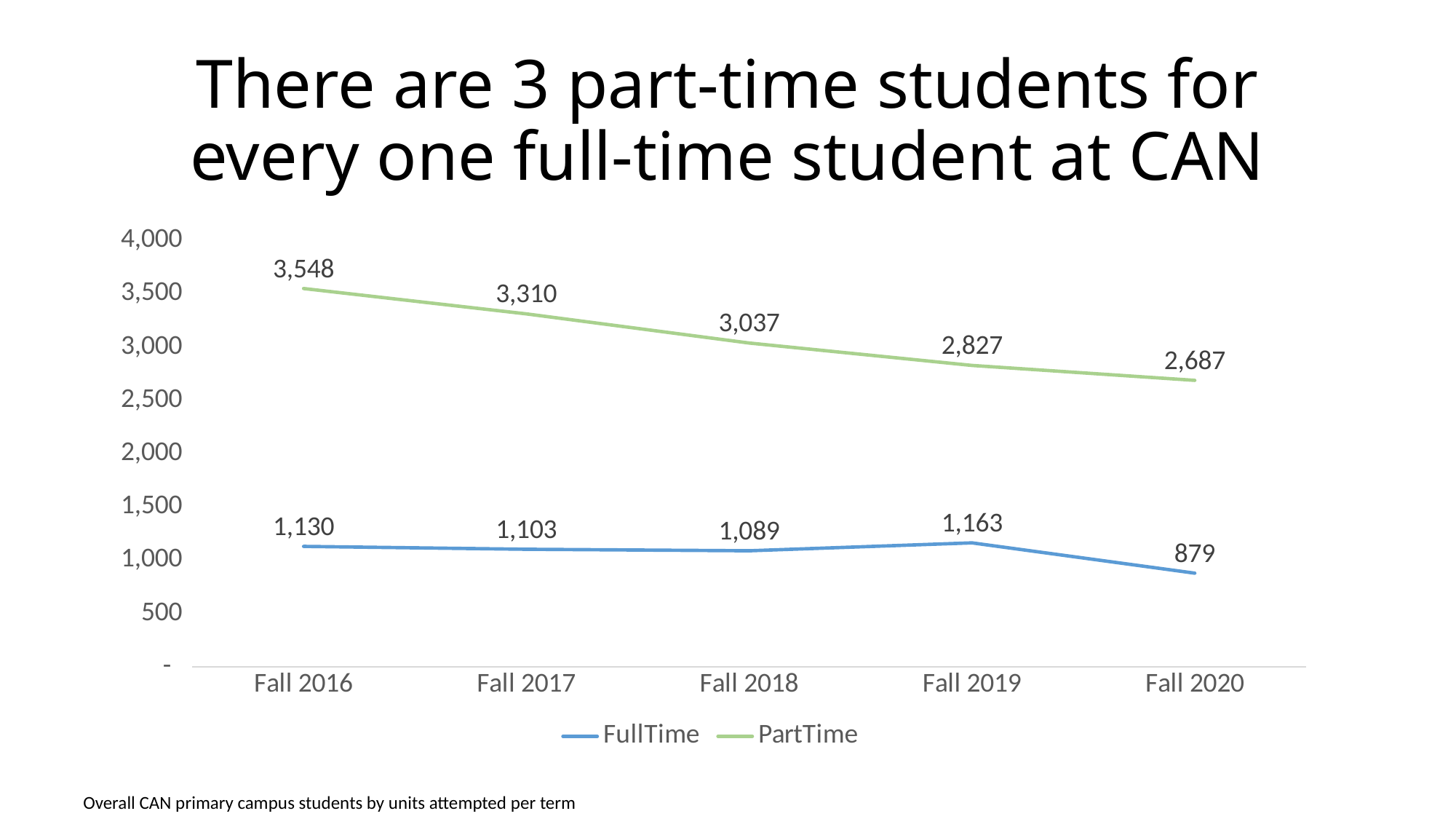
What is the PartTime value for Fall 2016? 3,548 How many terms are shown on the x axis? 5 In which term is the PartTime value lowest? Fall 2020 In which term is the FullTime value highest? Fall 2019 What is the PartTime value for Fall 2018? 3,037 How many series does the legend list? 2 Does the PartTime series rise or fall from Fall 2016 to Fall 2020? fall Which is larger in Fall 2019: the FullTime value or the PartTime value? PartTime What kind of chart is shown on the slide? line chart What is the FullTime value for Fall 2020? 879 What is the difference between the PartTime and FullTime values in Fall 2020? 1,808 Is the PartTime value for Fall 2019 greater or less than 3,000? less